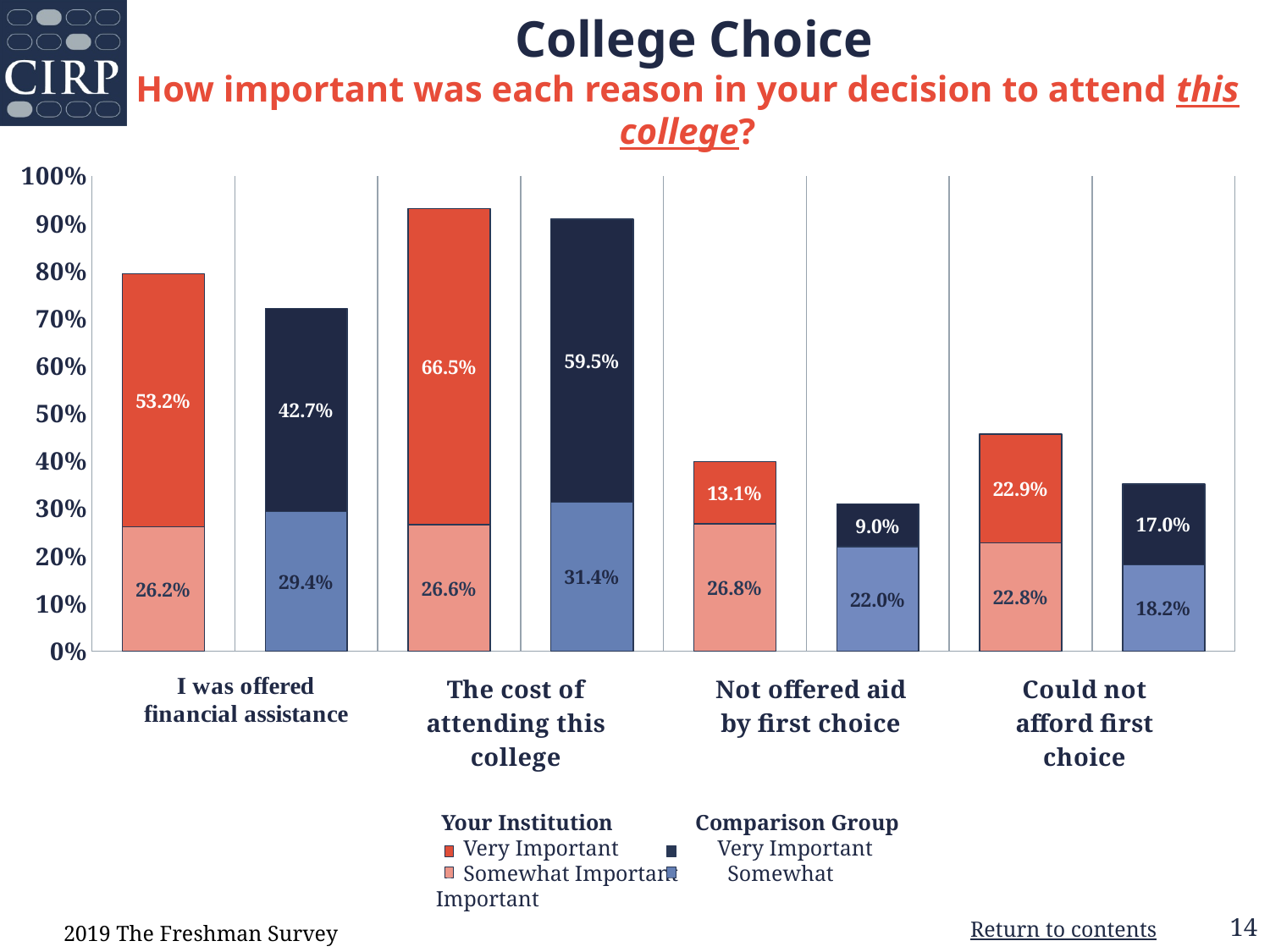
What percentage of Your Institution students rated "The cost of attending this college" as Very Important? 66.5% Which reason has the highest Very Important percentage for Your Institution? The cost of attending this college What is the total of the Comparison Group bar for "The cost of attending this college"? 90.9% How many series does the legend list? 4 What type of chart is shown on the slide? Stacked bar chart What percentage of the Comparison Group rated "I was offered financial assistance" as Somewhat Important? 29.4% For "Could not afford first choice", which is larger: Your Institution's Very Important value or the Comparison Group's Very Important value? Your Institution What is the difference between Your Institution's and the Comparison Group's Very Important values for "I was offered financial assistance"? 10.5% How many reasons (categories) are shown on the x axis? 4 What is the Comparison Group's Very Important value for "Not offered aid by first choice"? 9.0% What is the total (Very Important plus Somewhat Important) of the Your Institution bar for "Could not afford first choice"? 45.7% Which reason has the lowest Very Important percentage for the Comparison Group? Not offered aid by first choice